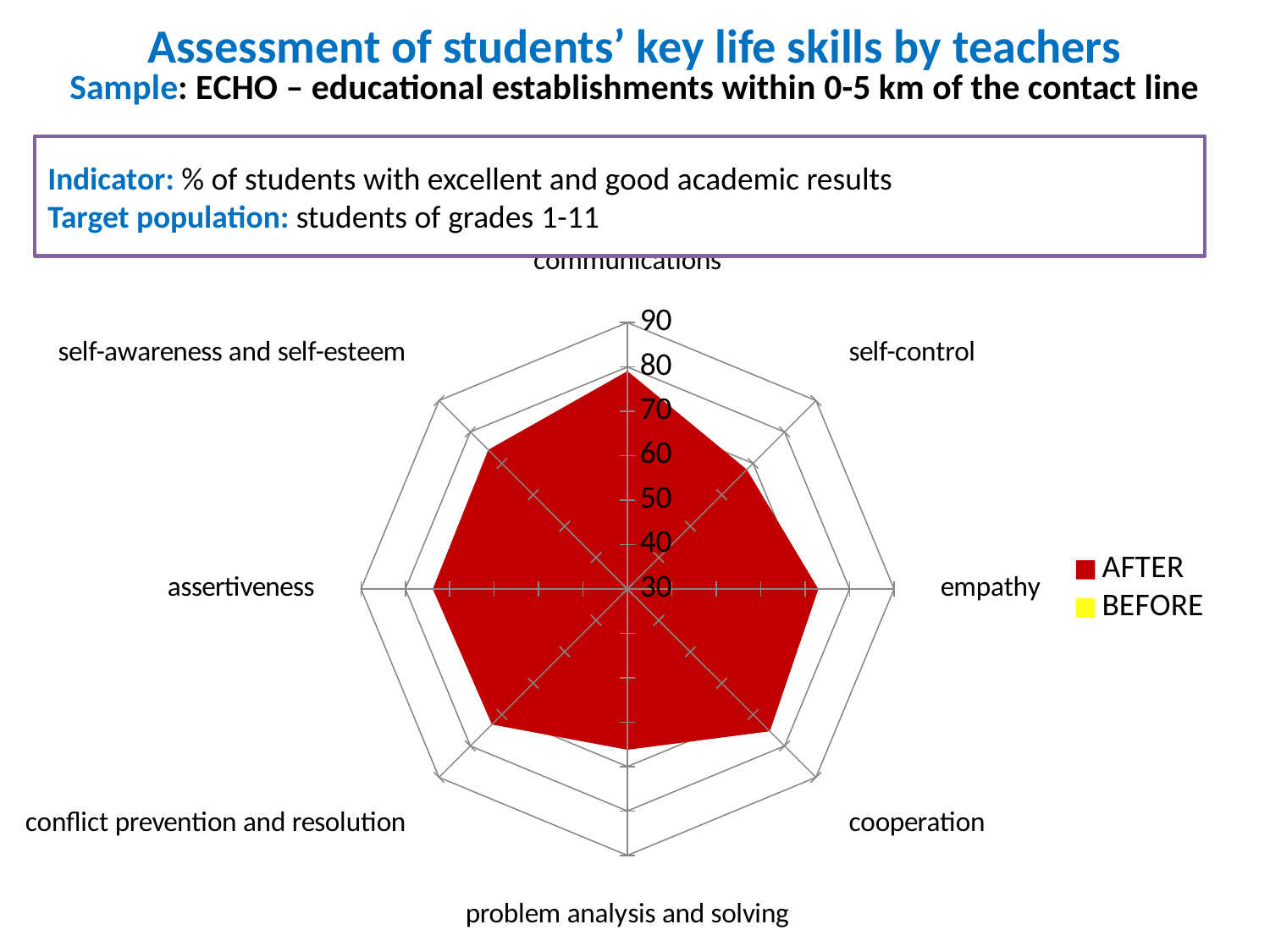
How many skill categories are plotted on the radar chart? 8 What is the highest value shown on the radar chart's axis scale? 90 What kind of chart is shown on the slide? radar chart Which has the larger AFTER value, communications or self-control? communications Is the AFTER value for communications greater or less than 70? greater Which series is shown in red in the legend? AFTER Which skill category has the highest AFTER value? communications Is the AFTER value for cooperation greater or less than 60? greater How many series does the legend list? 2 Is the AFTER value for empathy greater or less than 70? greater